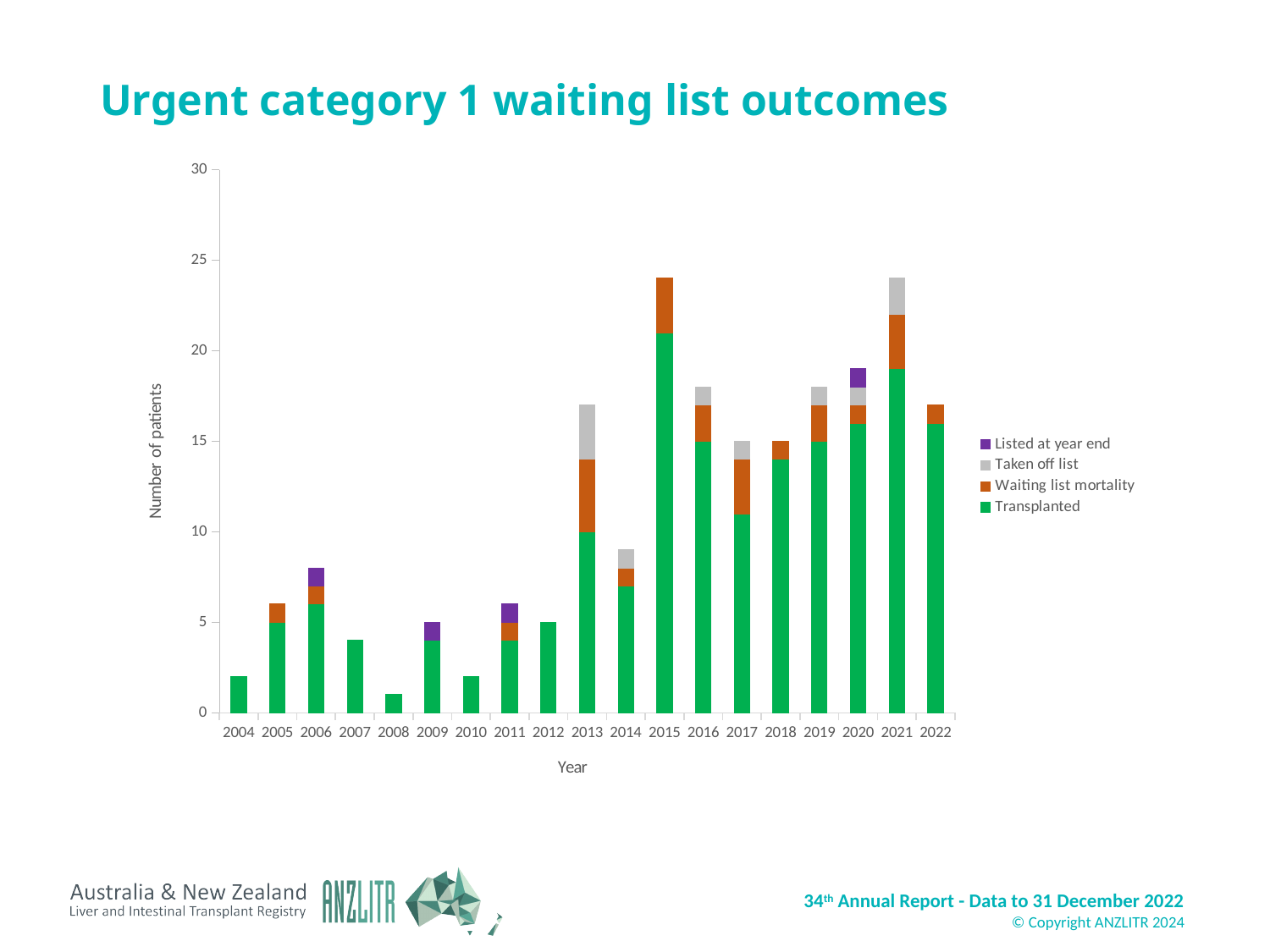
Is the total number of patients for 2014 greater or less than 10? less What is the total number of patients for 2012? 5 Is the total number of patients for 2015 greater or less than 20? greater What is the title of the chart? Urgent category 1 waiting list outcomes Is the total number of patients for 2013 greater or less than 15? greater Which year has a larger total number of patients, 2013 or 2014? 2013 How many series does the legend list? 4 Which year has a larger total number of patients, 2016 or 2017? 2016 Which year has the lowest total number of patients? 2008 What kind of chart is shown on the slide? Stacked bar chart Which colour represents the Transplanted series in the legend? Green How many years are shown on the x axis? 19